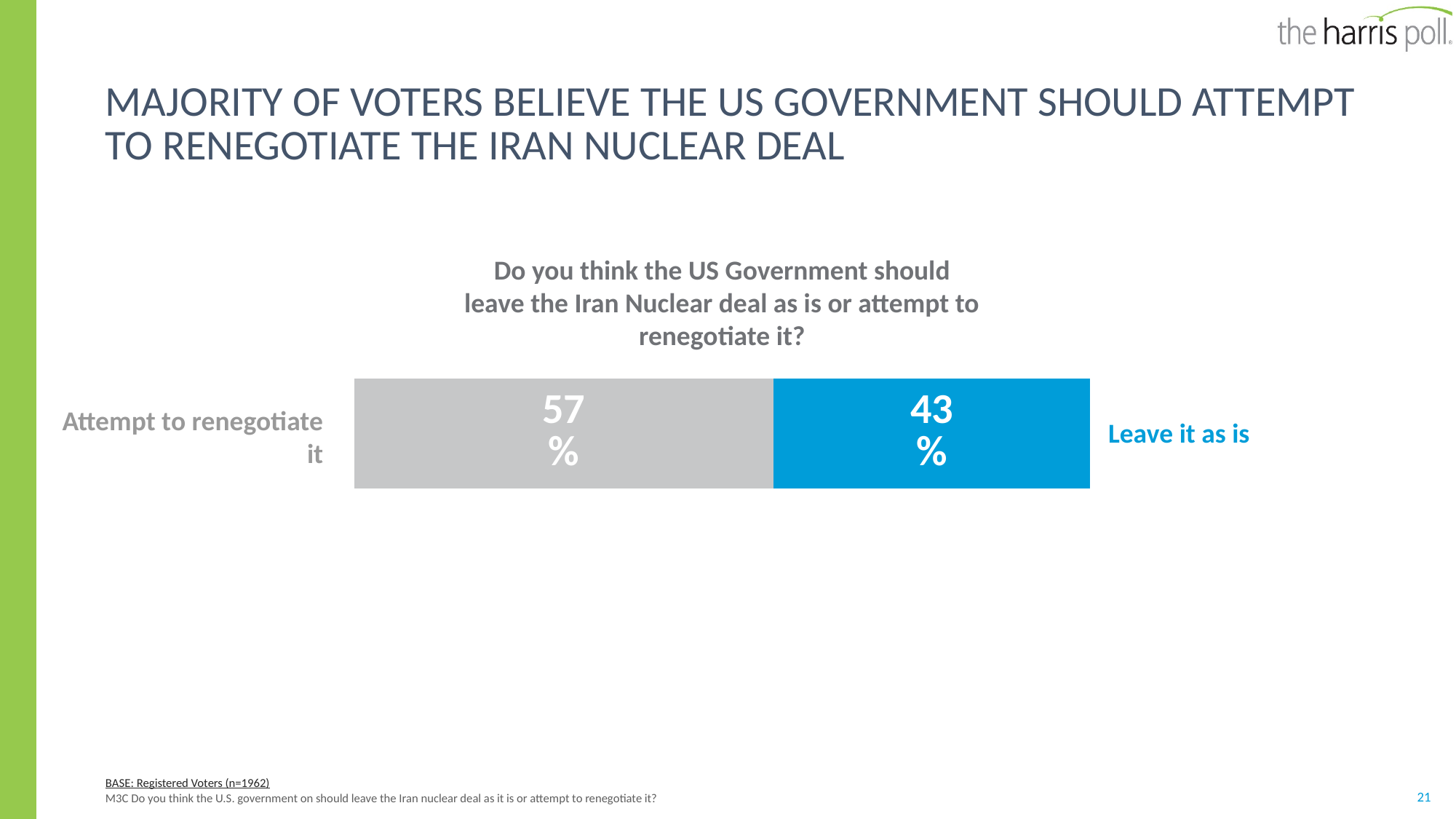
What is the difference in percentage points between 'Attempt to renegotiate it' and 'Leave it as is'? 14 What is the title of the chart? Do you think the US Government should leave the Iran Nuclear deal as is or attempt to renegotiate it? What percentage of voters say the US Government should attempt to renegotiate the Iran Nuclear deal? 57% Which response has the larger share: 'Attempt to renegotiate it' or 'Leave it as is'? Attempt to renegotiate it How many response categories are shown in the chart? 2 What kind of chart is shown on the slide? Stacked bar chart What is the total of the two segments in the stacked bar? 100% Is the value for 'Leave it as is' greater or less than 50%? less Which response received the lowest share of voters? Leave it as is What percentage of voters say the US Government should leave the Iran Nuclear deal as is? 43% What colour is the 'Leave it as is' segment of the bar? Blue